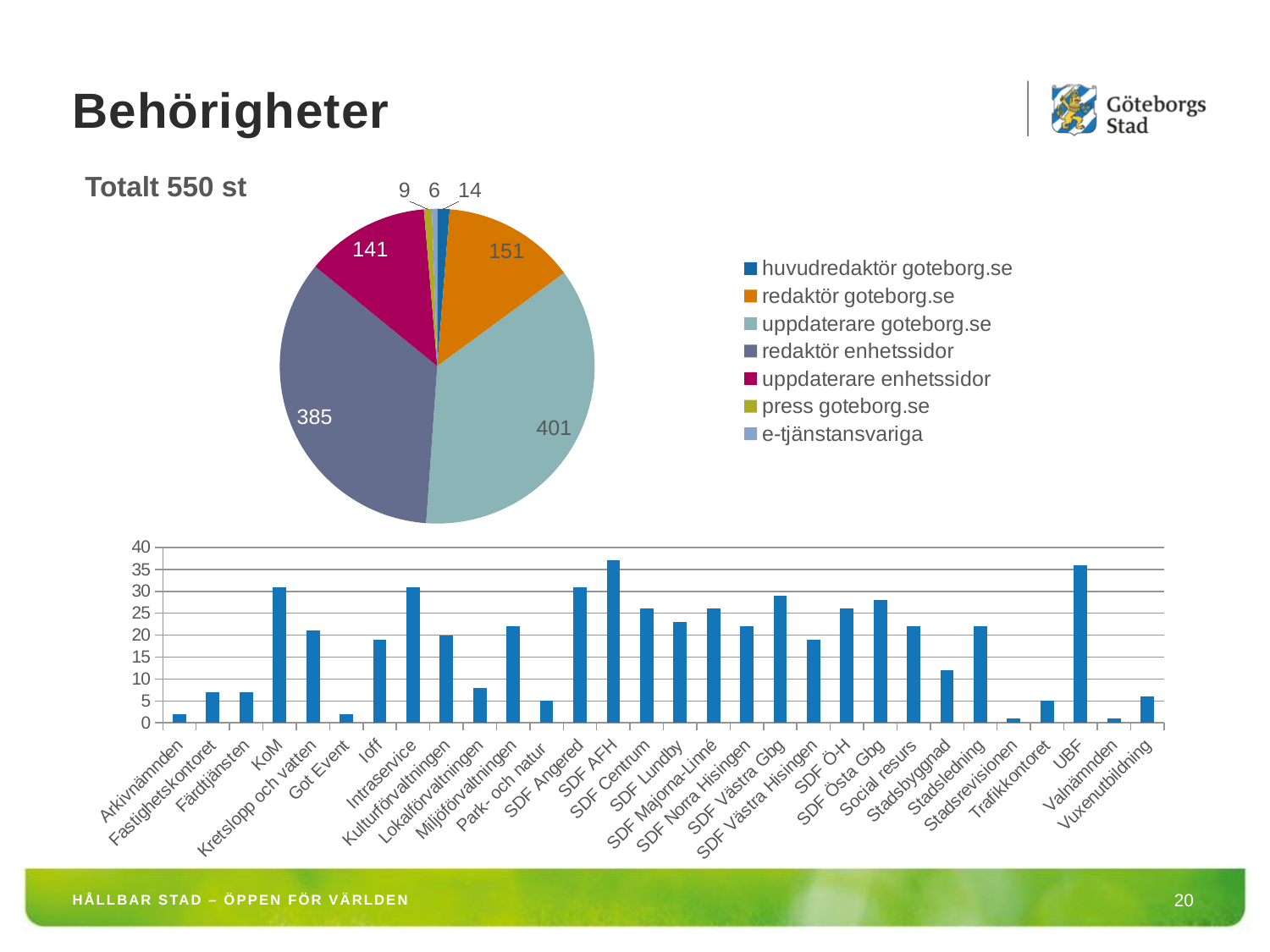
In the pie chart, what is the value for uppdaterare goteborg.se? 401 How many entries does the legend of the pie chart list? 7 In the pie chart, what is the value for redaktör enhetssidor? 385 In the pie chart, which is larger: redaktör goteborg.se or uppdaterare enhetssidor? redaktör goteborg.se In the bar chart, is the value for SDF AFH greater or less than 35? greater In the bar chart, is the value for Stadsbyggnad greater or less than 15? less In the pie chart, which category has the smallest slice? e-tjänstansvariga In the pie chart, which category has the largest slice? uppdaterare goteborg.se In the pie chart, what is the value for huvudredaktör goteborg.se? 14 What kind of chart is the lower chart on the slide? bar chart In the pie chart, what is the difference between the values for uppdaterare goteborg.se and redaktör enhetssidor? 16 How many categories are shown on the x axis of the bar chart? 30